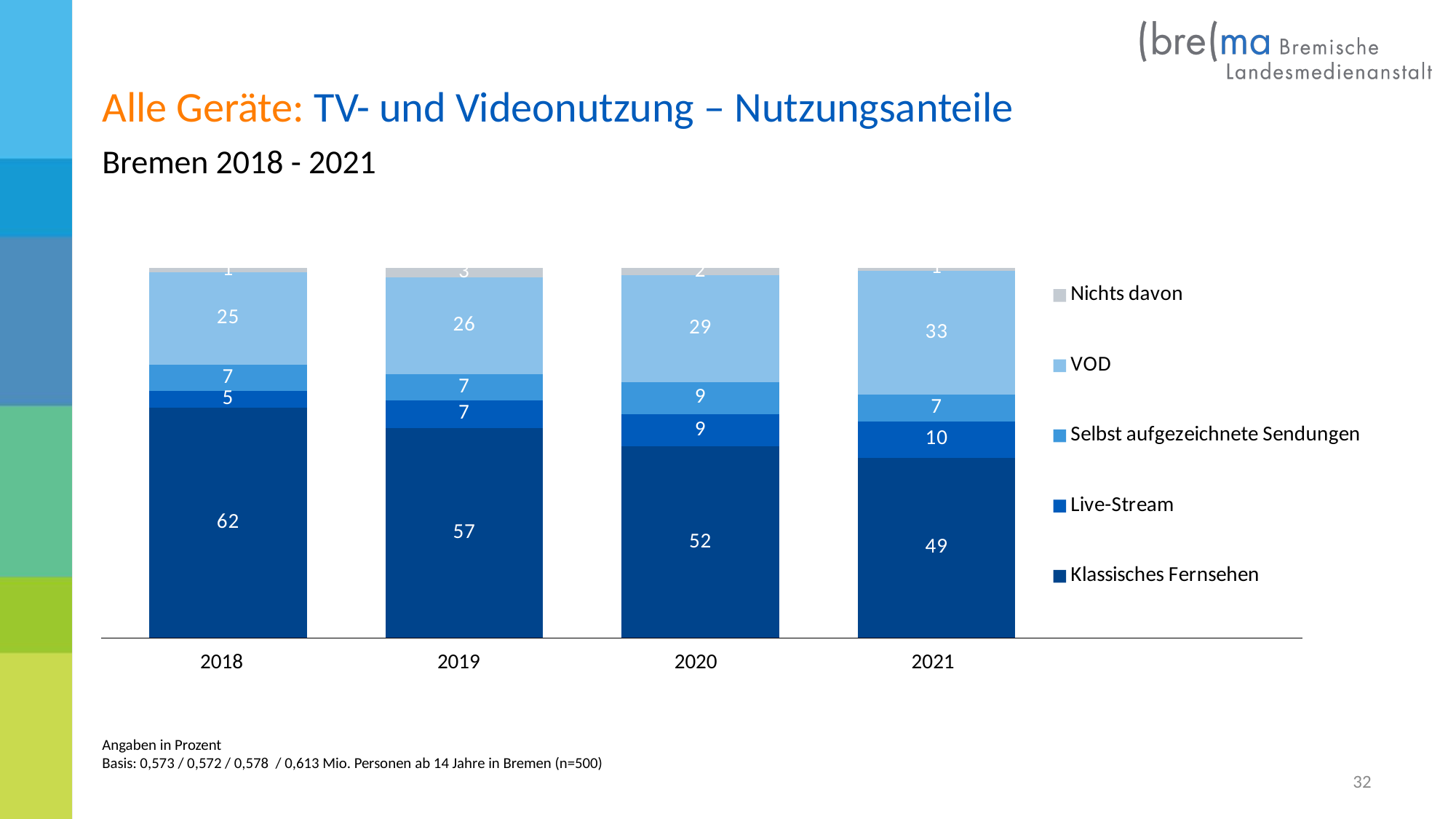
Which is larger, the Live-Stream value in 2018 or in 2021? 2021 In which year is the value for VOD highest? 2021 Does the value for Klassisches Fernsehen rise or fall from 2018 to 2021? Fall How many years are shown on the x axis? 4 What is the value for Klassisches Fernsehen in 2018? 62 What is the value for Selbst aufgezeichnete Sendungen in 2019? 7 In which year is the value for Klassisches Fernsehen lowest? 2021 How many series does the legend list? 5 What is the value for VOD in 2021? 33 What is the difference between the Klassisches Fernsehen values for 2018 and 2021? 13 What is the value for Live-Stream in 2020? 9 What kind of chart is shown on the slide? Stacked bar chart